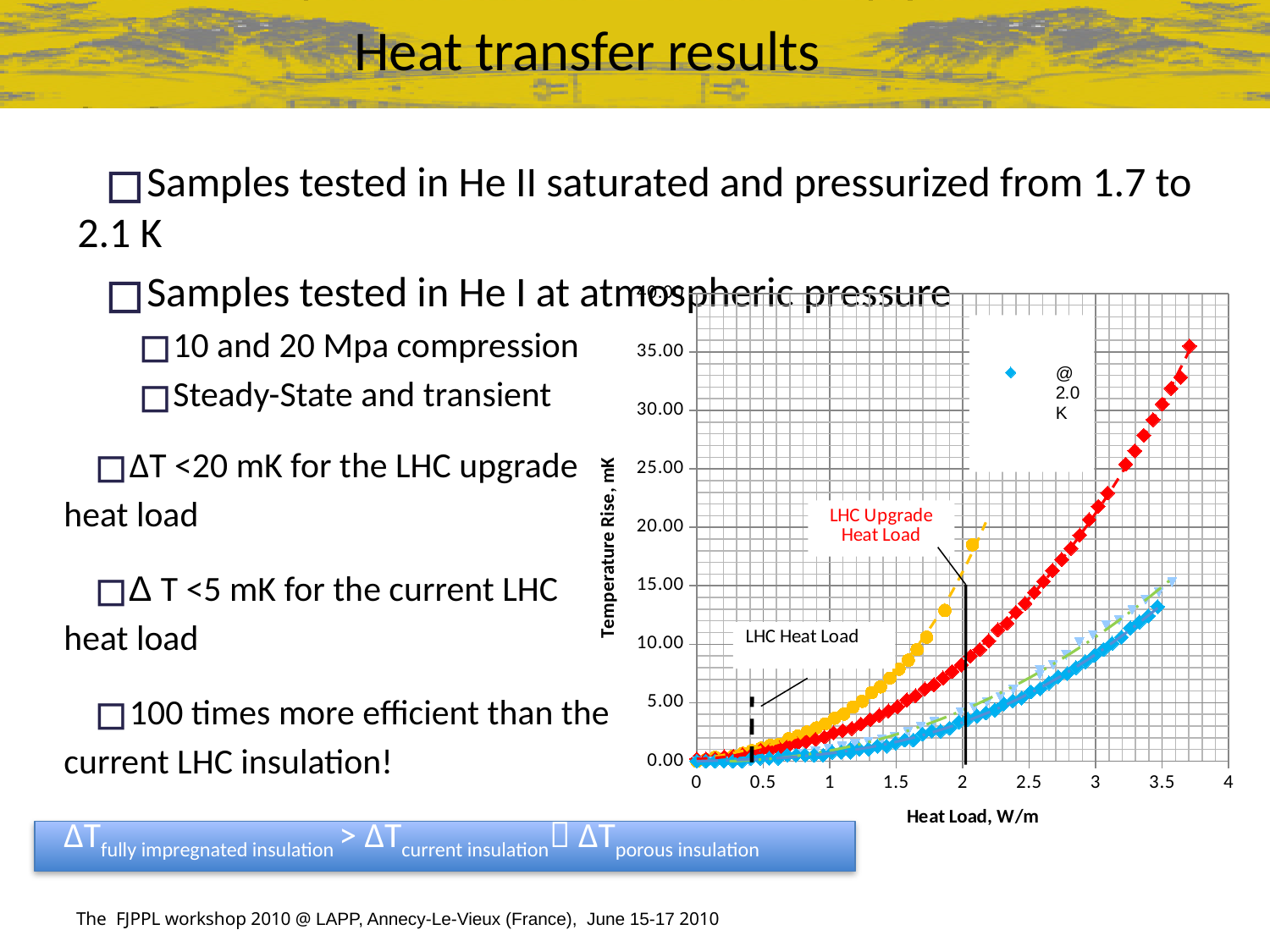
Is the temperature rise of the red series at a heat load of 2 W/m greater or less than 10 mK? less What kind of chart is shown on the slide? scatter chart Is the temperature rise of the red series at a heat load of 3 W/m greater or less than 20 mK? greater What is the highest value shown on the y axis of the chart? 40.00 Do the temperature rise values increase or decrease as heat load increases along the x axis? increase How many data series are plotted on the chart? 4 Which series reaches the highest temperature rise on the chart? the red series What is the highest value shown on the x axis of the chart? 4 What is the title of the x axis of the chart? Heat Load, W/m At what heat load on the x axis is the vertical line labelled 'LHC Upgrade Heat Load' drawn? 2 What is the title of the y axis of the chart? Temperature Rise, mK